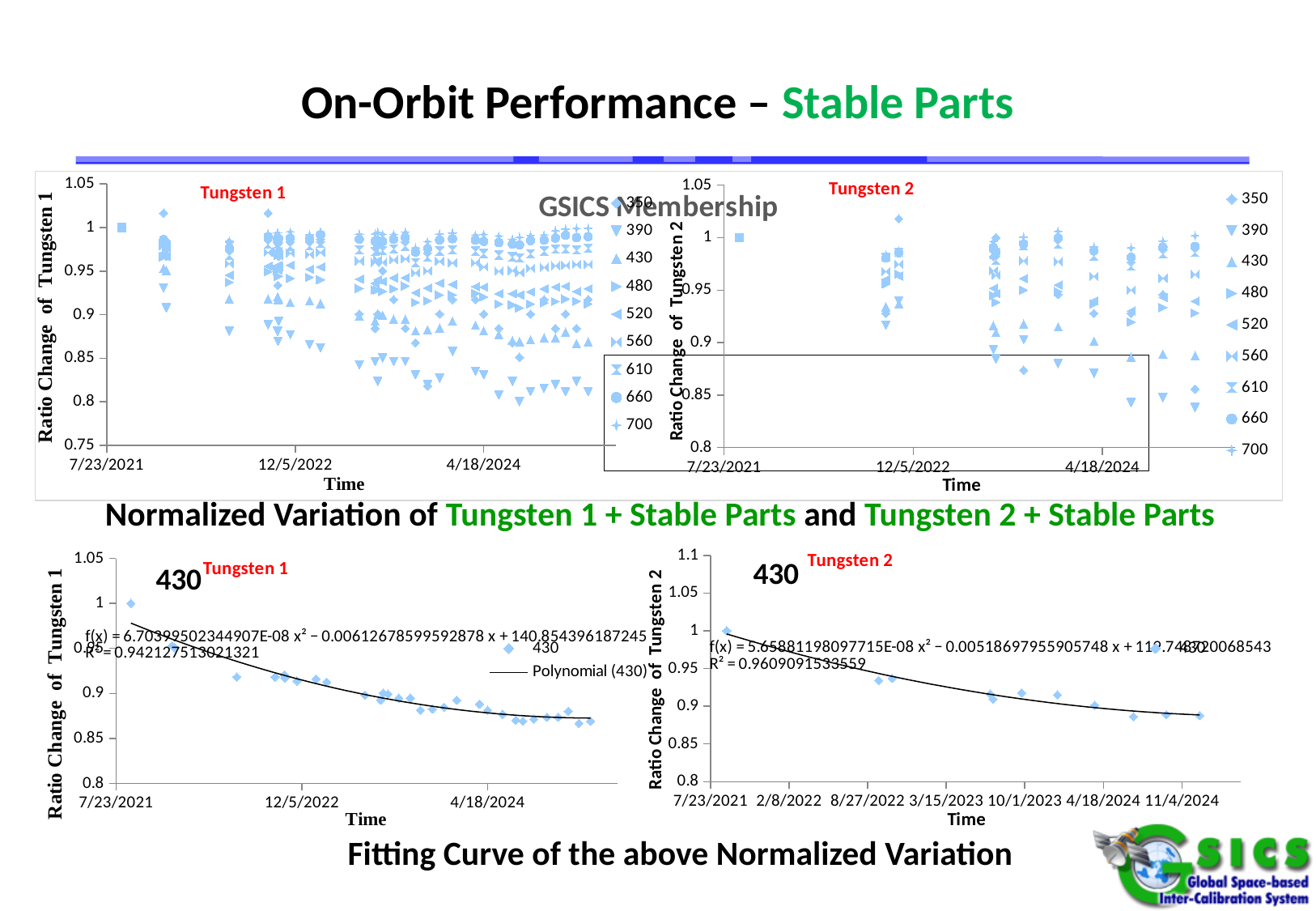
What is the x-axis title of the top-left Tungsten 1 chart? Time What R² value is printed on the bottom-left Tungsten 1 fitting chart? 0.942127513021321 In the bottom-right Tungsten 2 fitting chart, is the last plotted 430 value greater or less than 0.9? less In the bottom-left Tungsten 1 fitting chart, do the 430 values rise or fall over time? fall What R² value is printed on the bottom-right Tungsten 2 fitting chart? 0.9609091533559 How many series does the legend of the top-right Tungsten 2 chart list? 9 How many series does the legend of the top-left Tungsten 1 chart list? 9 In the bottom-right Tungsten 2 fitting chart, do the 430 values rise or fall over time? fall What kind of chart is the top-left Tungsten 1 chart? scatter chart In the bottom-left Tungsten 1 fitting chart, is the last plotted 430 value greater or less than 0.9? less In the bottom-left Tungsten 1 fitting chart, how many entries does the legend list? 2 In the bottom-left Tungsten 1 fitting chart, which is larger: the first plotted 430 value or the last plotted 430 value? the first plotted value